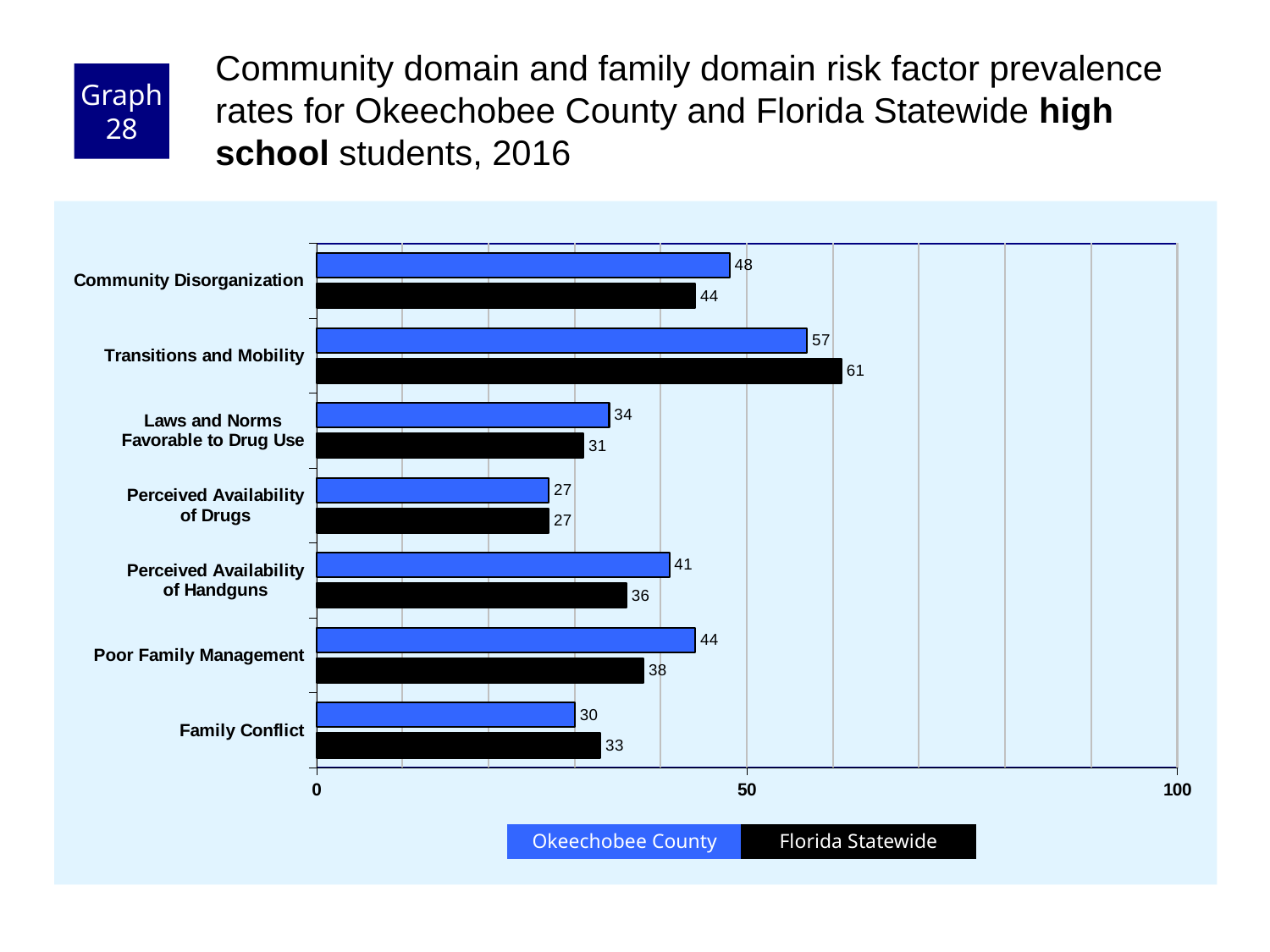
What is the difference between the Okeechobee County and Florida Statewide values for Poor Family Management? 6 How many risk factor categories are shown on the chart? 7 Which colour represents Florida Statewide in the chart? black What is the Okeechobee County value for Perceived Availability of Handguns? 41 What is the Okeechobee County value for Community Disorganization? 48 What is the Florida Statewide value for Transitions and Mobility? 61 Which risk factor has the highest Okeechobee County value? Transitions and Mobility Is the Florida Statewide value for Transitions and Mobility greater or less than 50? greater For Family Conflict, which is larger: the Okeechobee County value or the Florida Statewide value? Florida Statewide Which risk factor has the lowest Florida Statewide value? Perceived Availability of Drugs How many series does the legend list? 2 What kind of chart is shown on the slide? bar chart